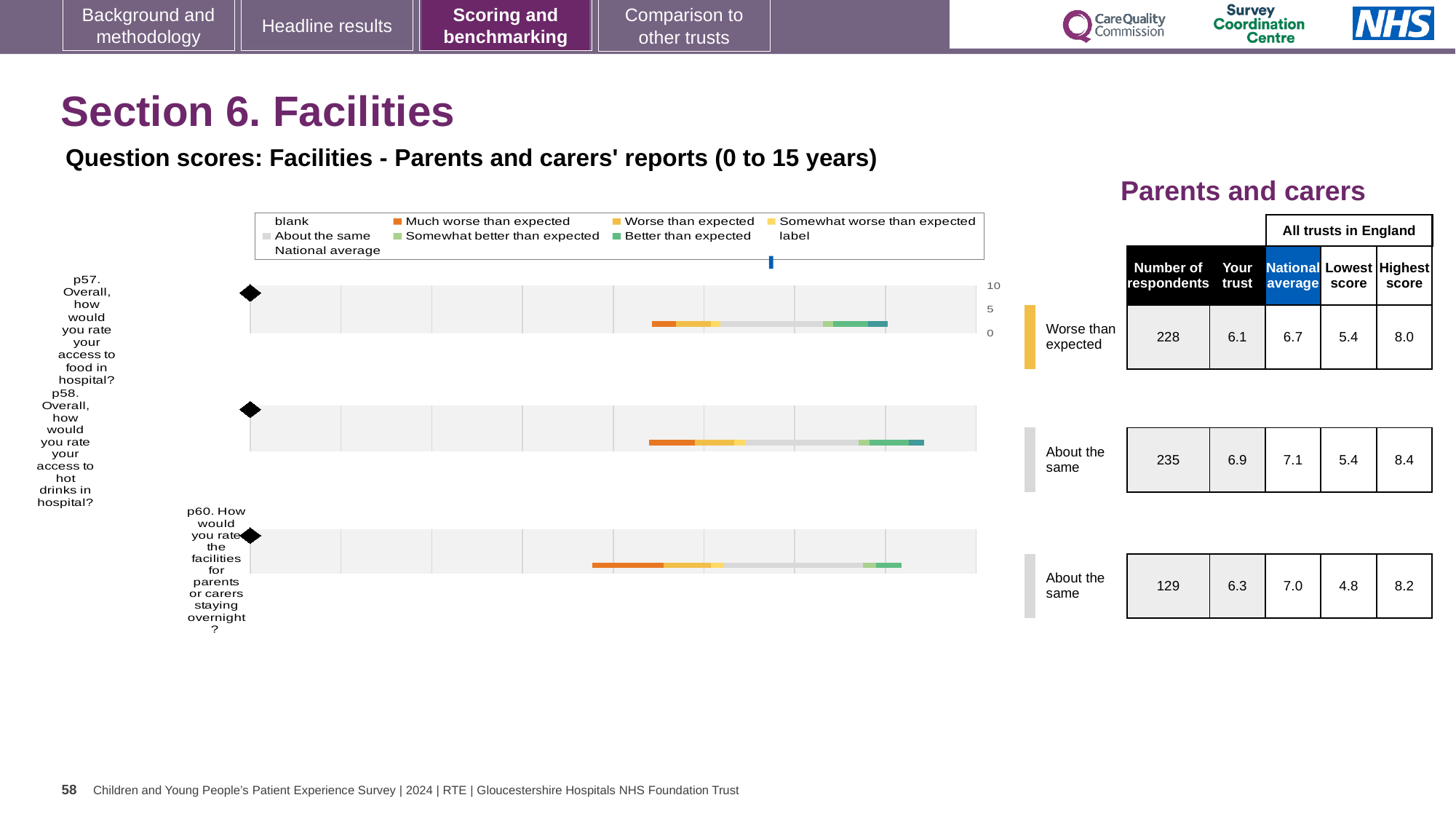
What is the difference between the national average and the 'Your trust' score for p57? 0.6 How many questions (categories) are plotted on the Facilities question scores chart? 3 Which question has the highest 'Your trust' score? p58 (access to hot drinks in hospital) What colour represents 'Much worse than expected' in the chart legend? Orange For p58, which is larger: the 'Your trust' score or the national average? National average What benchmark category is shown for p57 (access to food in hospital)? Worse than expected What is the highest score across all trusts in England for p58? 8.4 What is the 'Your trust' score for p57 (access to food in hospital)? 6.1 What is the difference between the highest and lowest scores across all trusts for p60? 3.4 Which question has the lowest number of respondents? p60 (facilities for parents or carers staying overnight) What kind of chart is used to show the question scores for Facilities? bar chart How many respondents answered p58 (access to hot drinks in hospital)? 235